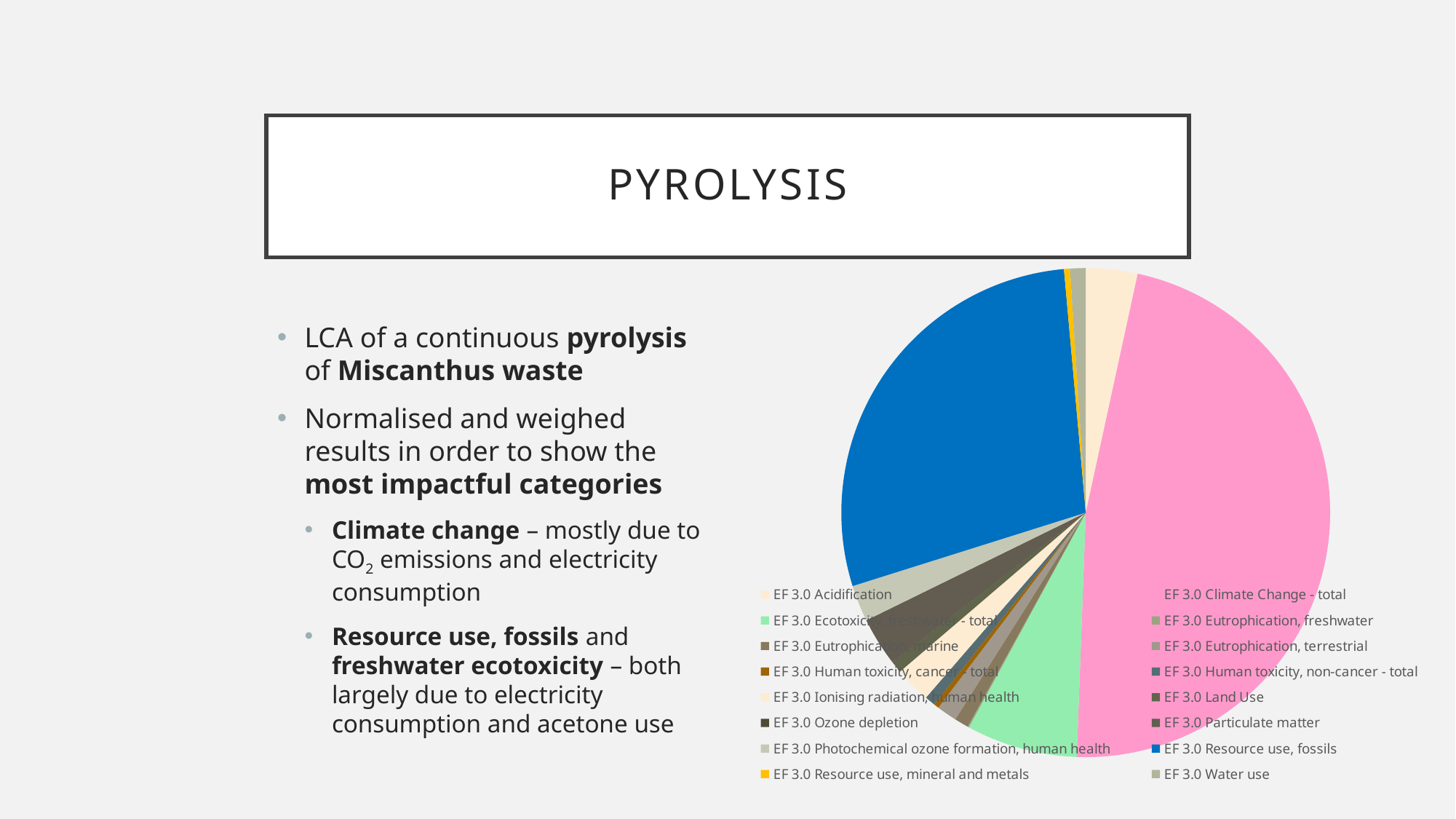
Which slice is larger: EF 3.0 Ecotoxicity, freshwater - total or EF 3.0 Water use? EF 3.0 Ecotoxicity, freshwater - total Which slice is larger: EF 3.0 Ecotoxicity, freshwater - total or EF 3.0 Acidification? EF 3.0 Ecotoxicity, freshwater - total Which slice is larger: EF 3.0 Climate Change - total or EF 3.0 Resource use, fossils? EF 3.0 Climate Change - total What colour is the slice for EF 3.0 Resource use, fossils in the pie chart? blue Which category has the largest slice of the pie chart? EF 3.0 Climate Change - total Which category has the second largest slice of the pie chart? EF 3.0 Resource use, fossils How many categories does the pie chart's legend list? 16 What kind of chart is shown on the slide? pie chart What colour is the slice for EF 3.0 Climate Change - total in the pie chart? pink